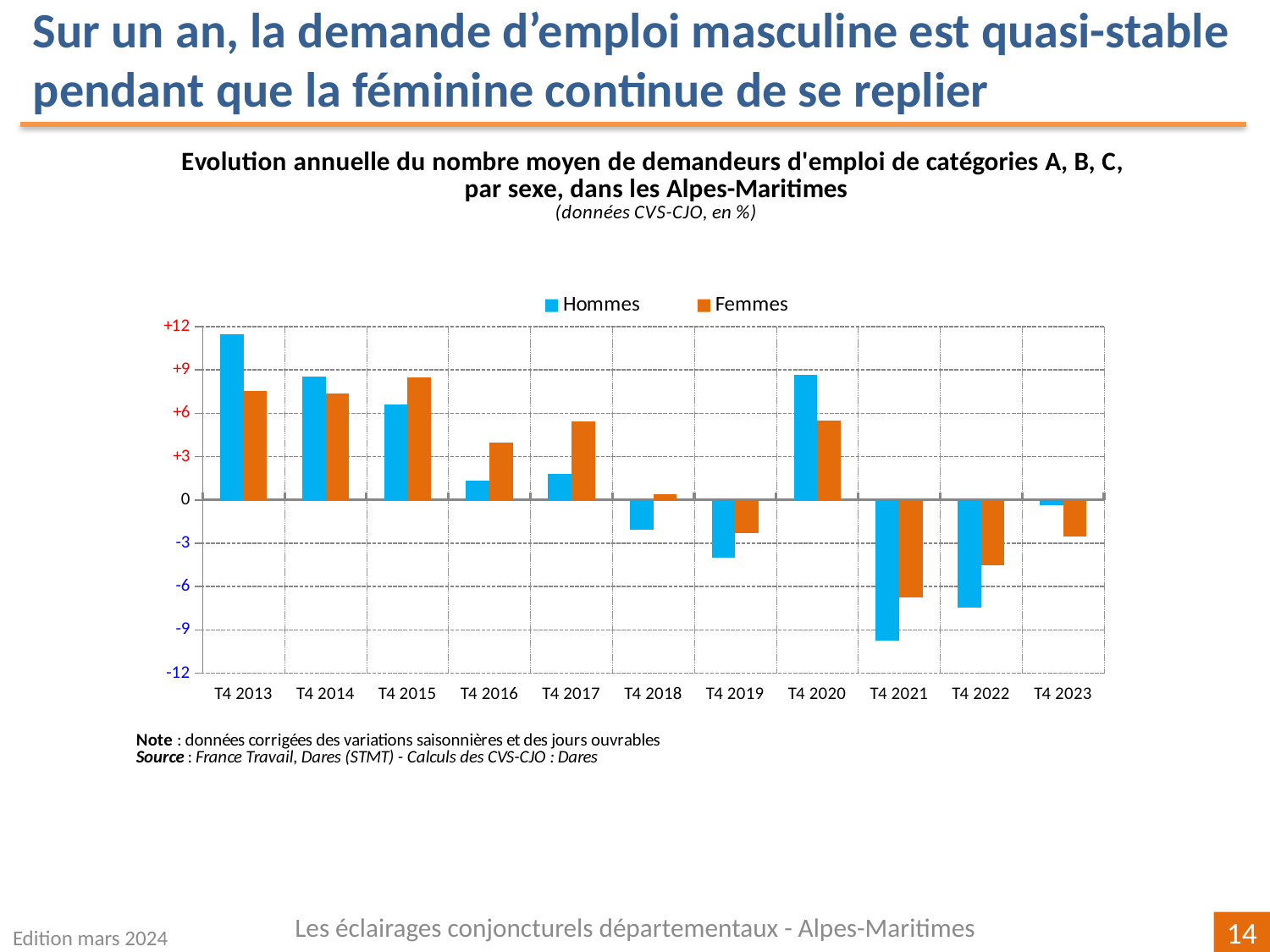
Is the Hommes value for T4 2022 greater or less than -6? less In which quarter is the Hommes value highest? T4 2013 In T4 2020, which series has the larger value, Hommes or Femmes? Hommes How many series does the legend list? 2 In which quarter is the Femmes value highest? T4 2015 What kind of chart is shown on the slide? bar chart Is the Hommes value for T4 2013 greater or less than +9? greater In which quarter is the Hommes value lowest? T4 2021 How many quarters (categories) are shown on the x axis? 11 Is the Femmes value for T4 2016 greater or less than +3? greater Do the Hommes values rise or fall from T4 2013 to T4 2016? fall In which quarter is the Femmes value lowest? T4 2021